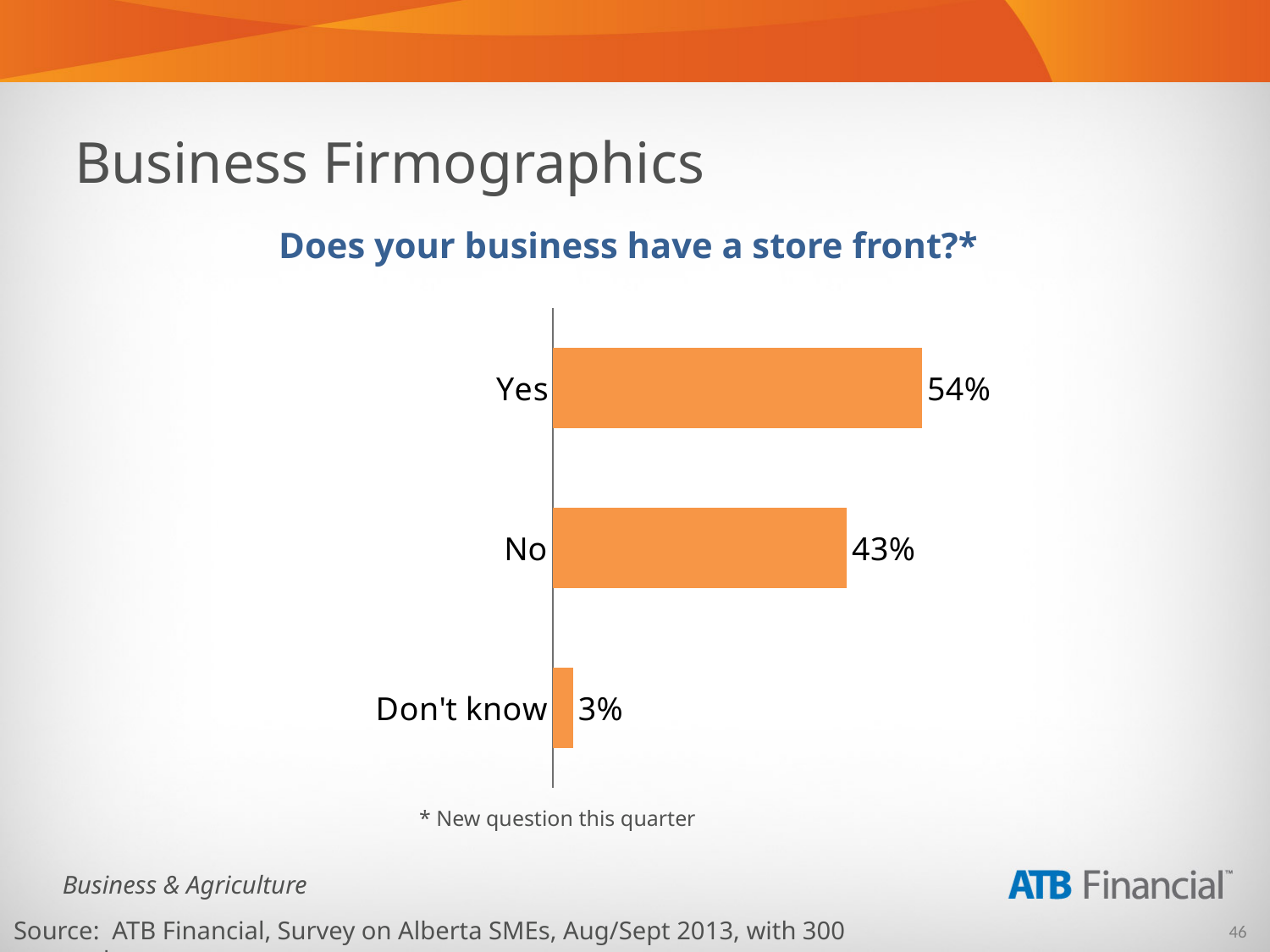
What is the title of the chart? Does your business have a store front?* What percentage of respondents answered "Don't know"? 3% What percentage of businesses answered "No" to having a store front? 43% How many response categories are shown in the chart? 3 What is the difference in percentage points between the "No" and "Don't know" responses? 40 Which response category has the highest value? Yes What is the difference in percentage points between the "Yes" and "No" responses? 11 Which is larger, the value for "Yes" or the value for "No"? Yes What does the asterisk footnote below the chart say? New question this quarter What percentage of businesses answered "Yes" to having a store front? 54% Which response category has the lowest value? Don't know What kind of chart is shown on the slide? Bar chart